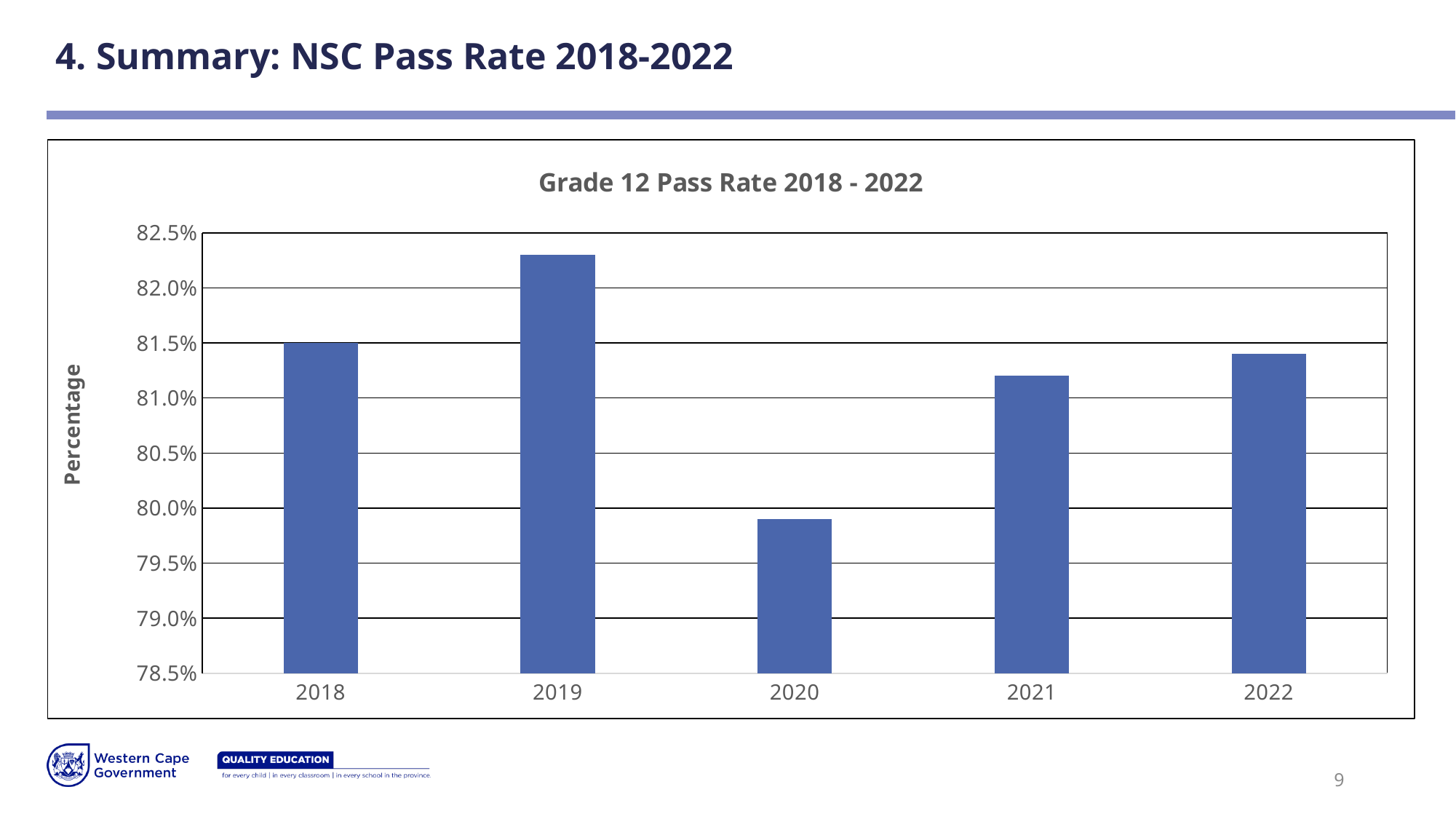
Did the pass rate rise or fall from 2019 to 2020? fall What is the title of the chart? Grade 12 Pass Rate 2018 - 2022 Which year has the lowest pass rate? 2020 Which year has the highest pass rate? 2019 What is the label on the vertical axis of the chart? Percentage What is the pass rate for 2018? 81.5% Is the pass rate for 2020 greater or less than 80.0%? less Which year has the higher pass rate, 2018 or 2021? 2018 Is the pass rate for 2021 greater or less than 81.0%? greater How many years are plotted on the chart? 5 What type of chart is shown on the slide? bar chart Is the pass rate for 2019 greater or less than 82.0%? greater